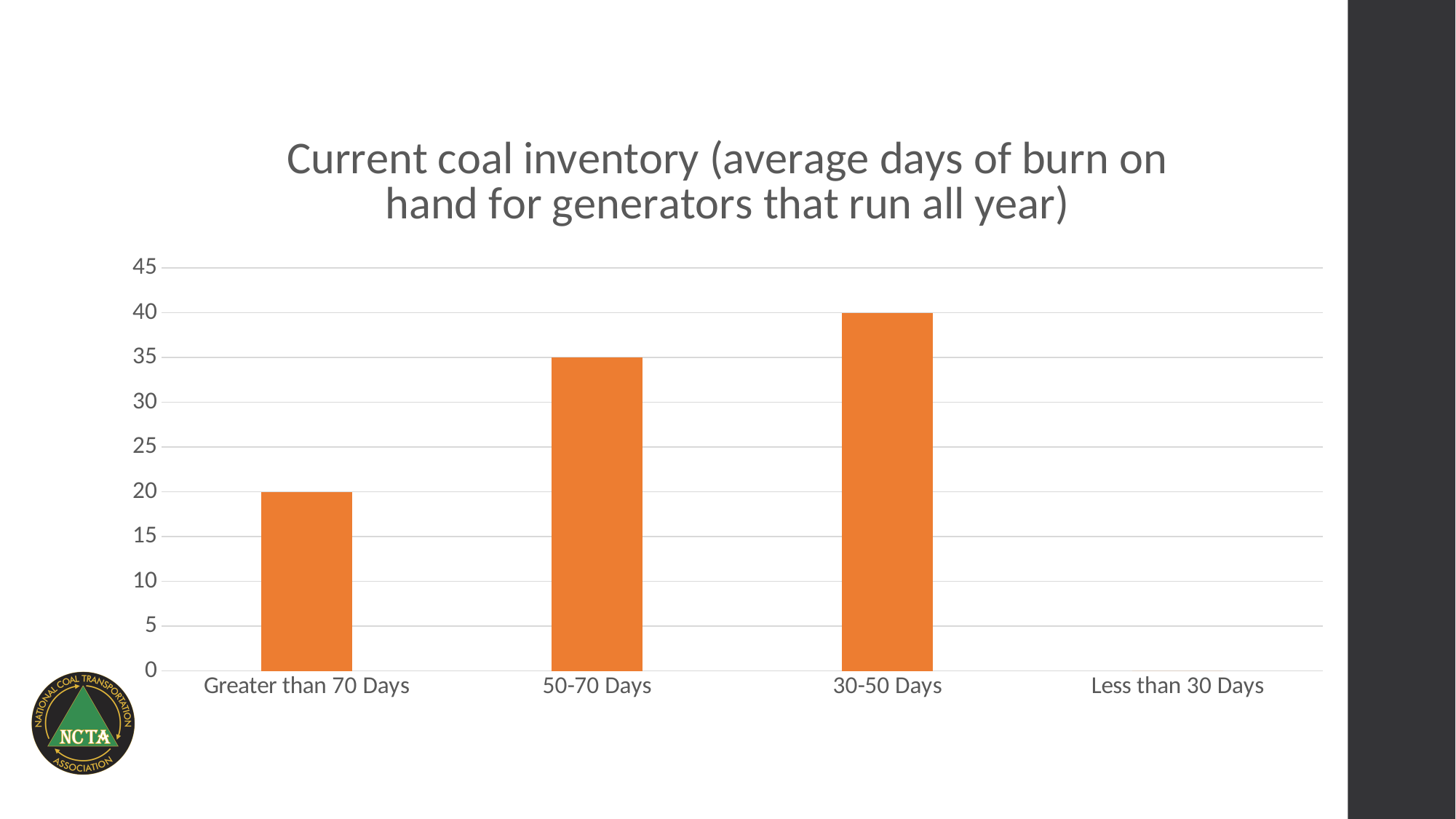
Do the values rise or fall from Greater than 70 Days to 30-50 Days? rise What colour are the bars in the chart? orange What is the value for the Greater than 70 Days category? 20 Which category has the tallest bar? 30-50 Days How many categories are shown on the x axis? 4 What is the difference between the values for 30-50 Days and Greater than 70 Days? 20 What is the value for the 50-70 Days category? 35 Which is larger, the value for 50-70 Days or the value for Greater than 70 Days? 50-70 Days What is the difference between the values for 30-50 Days and 50-70 Days? 5 What is the value for the 30-50 Days category? 40 Is the value for 50-70 Days greater or less than 30? greater What kind of chart is shown on the slide? bar chart